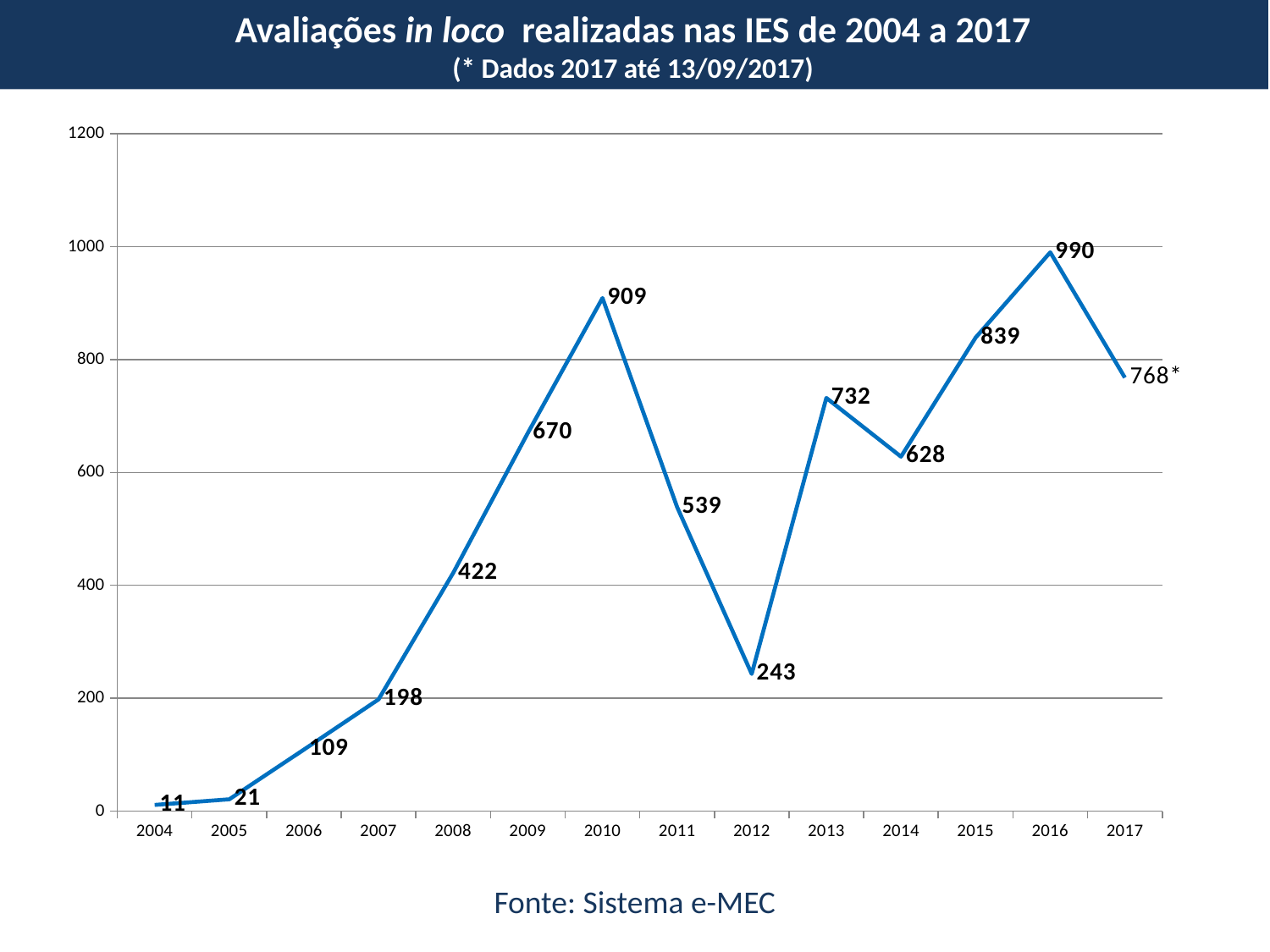
What source is cited below the chart? Sistema e-MEC Which year has the highest value? 2016 What is the value for 2010? 909 Which is larger, the value for 2013 or the value for 2014? 2013 Which year has the lowest value? 2004 What is the value for 2017? 768* What is the value for 2012? 243 Is the value for 2009 greater or less than 600? greater Do the values rise or fall from 2004 to 2010? rise What is the difference between the values for 2016 and 2015? 151 How many years are plotted on the x axis? 14 What kind of chart is shown? line chart